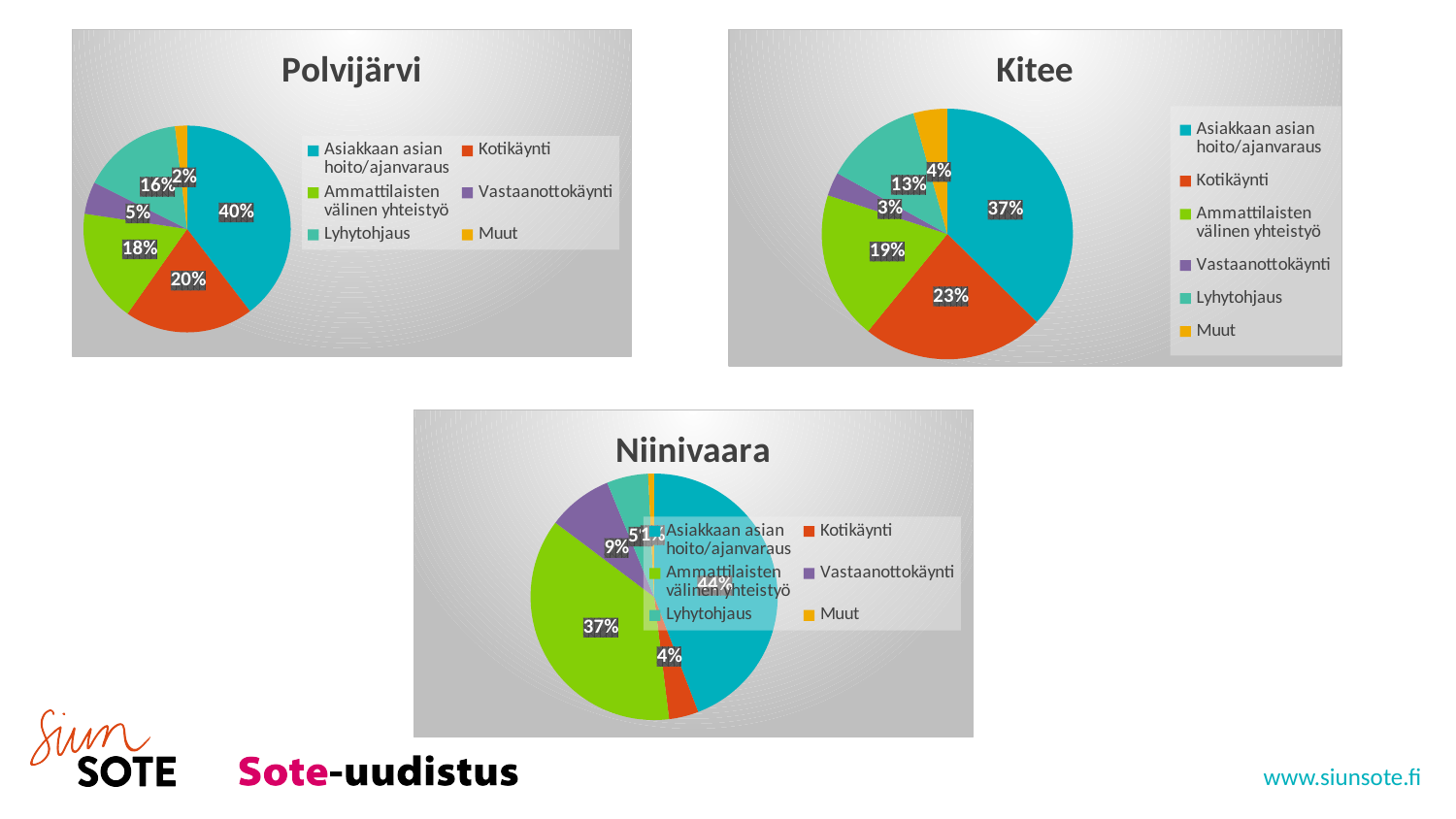
In the Kitee chart, which category has the largest slice? Asiakkaan asian hoito/ajanvaraus In the Niinivaara chart, what is the value for Ammattilaisten välinen yhteistyö? 37% In the Polvijärvi chart, what share does Asiakkaan asian hoito/ajanvaraus have? 40% In the Kitee chart, what is the value for Kotikäynti? 23% In the Kitee chart, which is larger, Lyhytohjaus or Vastaanottokäynti? Lyhytohjaus In the Kitee chart, what is the difference between Asiakkaan asian hoito/ajanvaraus and Ammattilaisten välinen yhteistyö? 18% How many categories does the legend of the Kitee chart list? 6 In the Niinivaara chart, what is the value for Vastaanottokäynti? 9% In the Polvijärvi chart, what is the value for Lyhytohjaus? 16% What type of chart is the Niinivaara chart? Pie chart In the Polvijärvi chart, what is the difference between Kotikäynti and Ammattilaisten välinen yhteistyö? 2% In the Polvijärvi chart, which category has the smallest slice? Muut